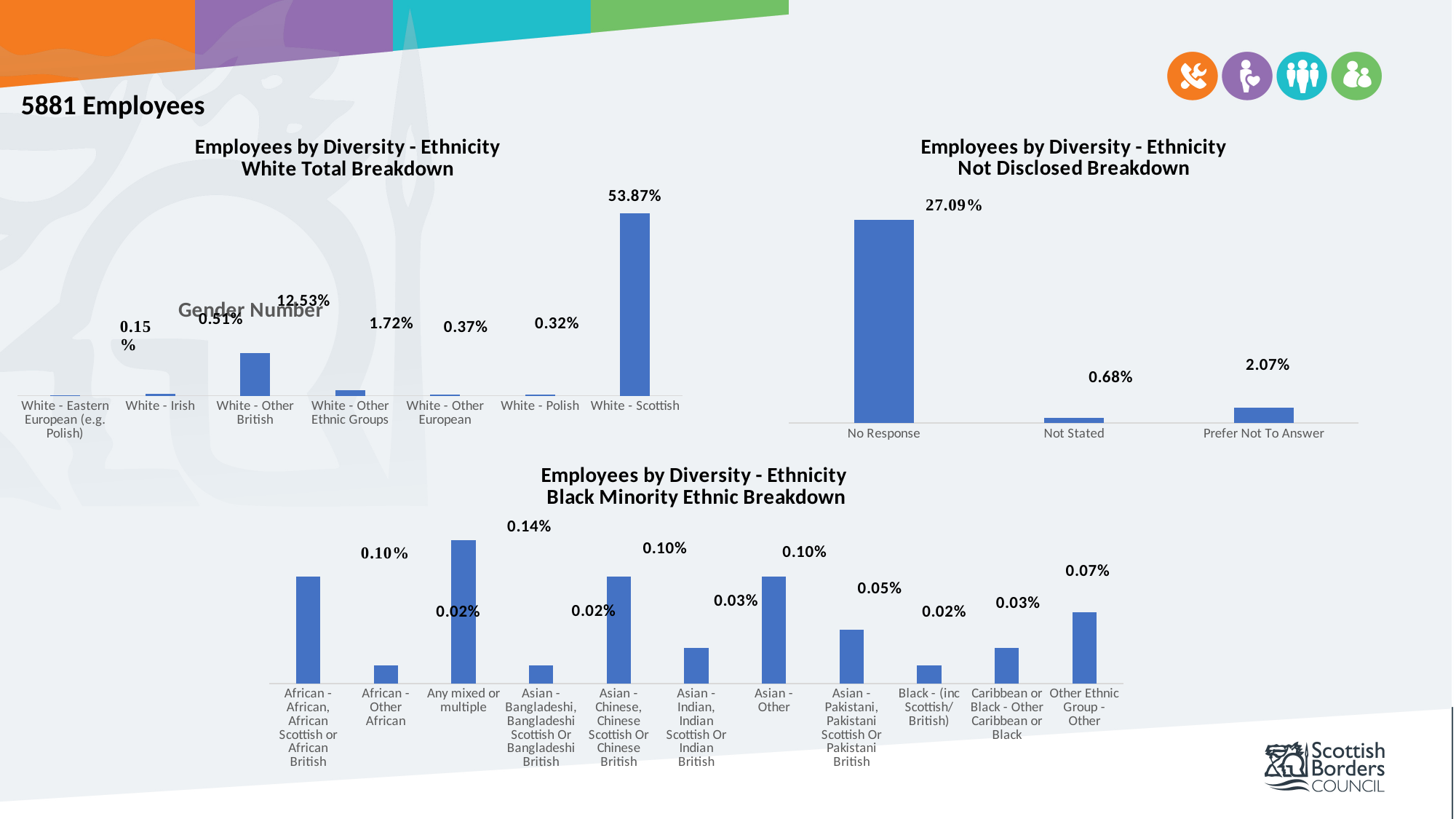
In the 'Employees by Diversity - Ethnicity White Total Breakdown' chart, how many categories are shown? 7 In the 'Employees by Diversity - Ethnicity Black Minority Ethnic Breakdown' chart, which category has the highest value? Any mixed or multiple In the 'Employees by Diversity - Ethnicity White Total Breakdown' chart, which category has the lowest value? White - Eastern European (e.g. Polish) In the 'Employees by Diversity - Ethnicity White Total Breakdown' chart, what is the value for White - Scottish? 53.87% In the 'Employees by Diversity - Ethnicity White Total Breakdown' chart, what is the difference between White - Scottish and White - Other British? 41.34% In the 'Employees by Diversity - Ethnicity Not Disclosed Breakdown' chart, how many categories are shown? 3 In the 'Employees by Diversity - Ethnicity Black Minority Ethnic Breakdown' chart, how many categories are shown? 11 In the 'Employees by Diversity - Ethnicity Not Disclosed Breakdown' chart, what is the value for No Response? 27.09% In the 'Employees by Diversity - Ethnicity Not Disclosed Breakdown' chart, which is larger, Not Stated or Prefer Not To Answer? Prefer Not To Answer In the 'Employees by Diversity - Ethnicity White Total Breakdown' chart, what is the value for White - Other British? 12.53% In the 'Employees by Diversity - Ethnicity Black Minority Ethnic Breakdown' chart, what is the value for Other Ethnic Group - Other? 0.07% What kind of chart is the 'Employees by Diversity - Ethnicity Not Disclosed Breakdown' chart? Bar chart